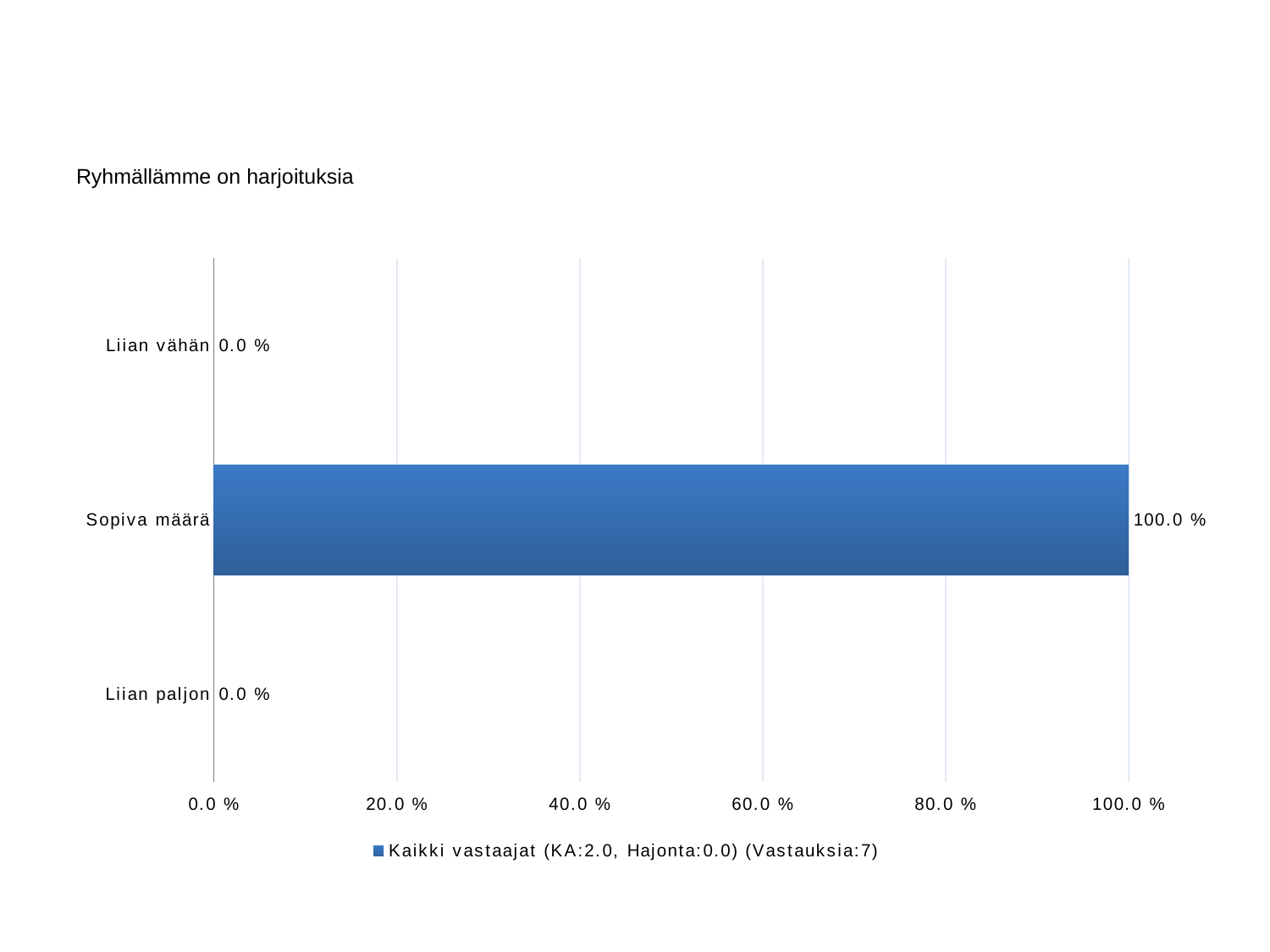
How many responses (Vastauksia) does the legend entry report? 7 What is the value for Liian paljon? 0.0 % What is the difference between the values for Sopiva määrä and Liian vähän? 100.0 % What is the value for Sopiva määrä? 100.0 % What is the value for Liian vähän? 0.0 % What kind of chart is shown on the slide? bar chart How many series does the legend list? 1 What is the title of the chart? Ryhmällämme on harjoituksia Is the value for Sopiva määrä greater or less than 60.0 %? greater How many categories are shown on the chart? 3 Which category has the highest value? Sopiva määrä Which is larger, the value for Sopiva määrä or the value for Liian paljon? Sopiva määrä